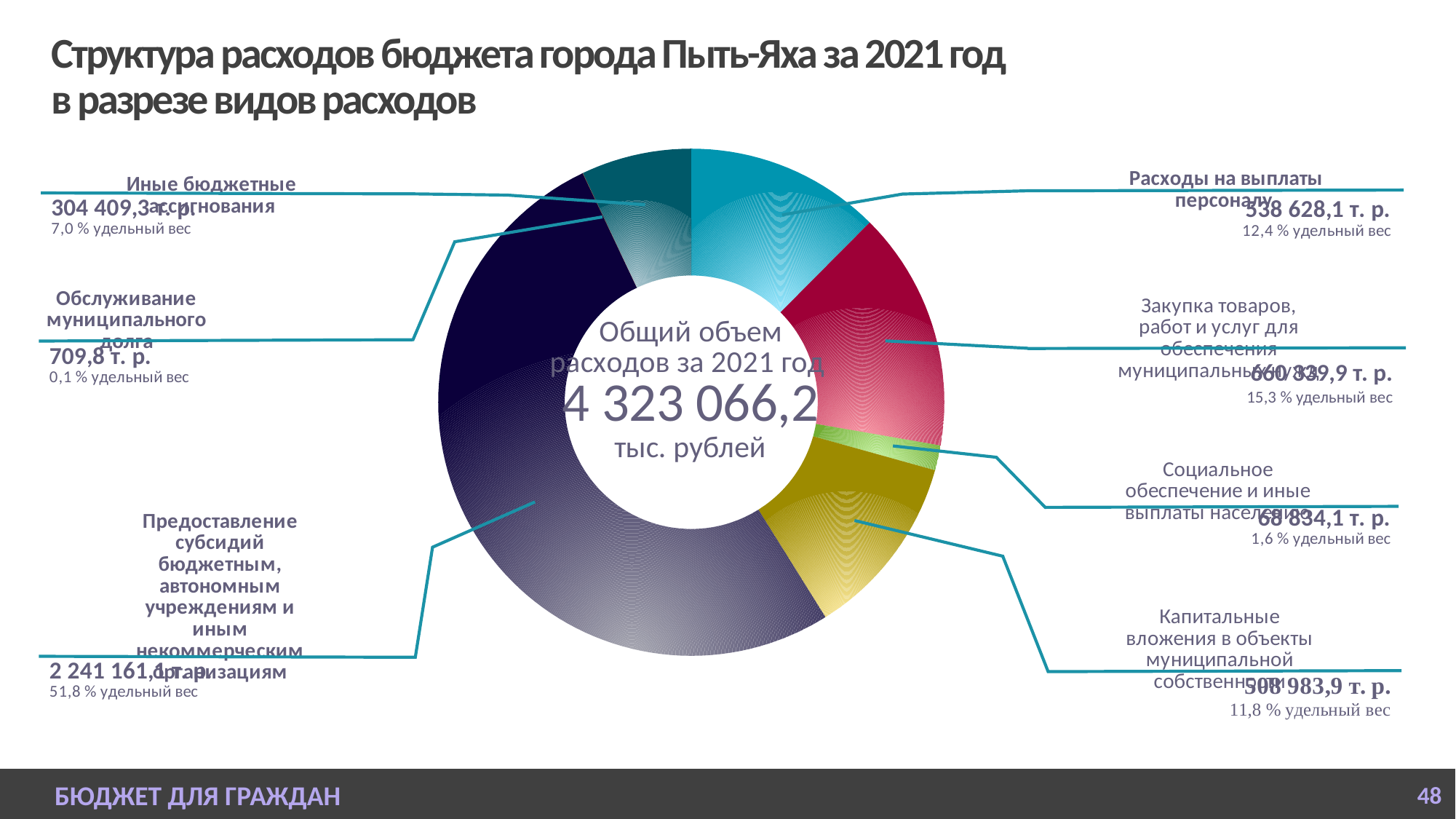
How many expenditure categories are shown on the chart? 7 Which expenditure category has the largest share? Предоставление субсидий бюджетным, автономным учреждениям и иным некоммерческим организациям What kind of chart is shown on the slide? Pie (donut) chart What is the value for «Расходы на выплаты персоналу»? 538 628,1 т. р. What share of expenditures does «Предоставление субсидий бюджетным, автономным учреждениям и иным некоммерческим организациям» account for? 51,8 % What share of expenditures does «Закупка товаров, работ и услуг для обеспечения муниципальных нужд» account for? 15,3 % Which is larger: «Иные бюджетные ассигнования» or «Социальное обеспечение и иные выплаты населению»? Иные бюджетные ассигнования What is the value for «Капитальные вложения в объекты муниципальной собственности»? 508 983,9 т. р. What is the difference between «Расходы на выплаты персоналу» and «Капитальные вложения в объекты муниципальной собственности»? 29 644,2 т. р. What is the total volume of expenditures for 2021 shown in the centre of the chart? 4 323 066,2 тыс. рублей What is the value for «Социальное обеспечение и иные выплаты населению»? 68 834,1 т. р. Which expenditure category has the smallest share? Обслуживание муниципального долга